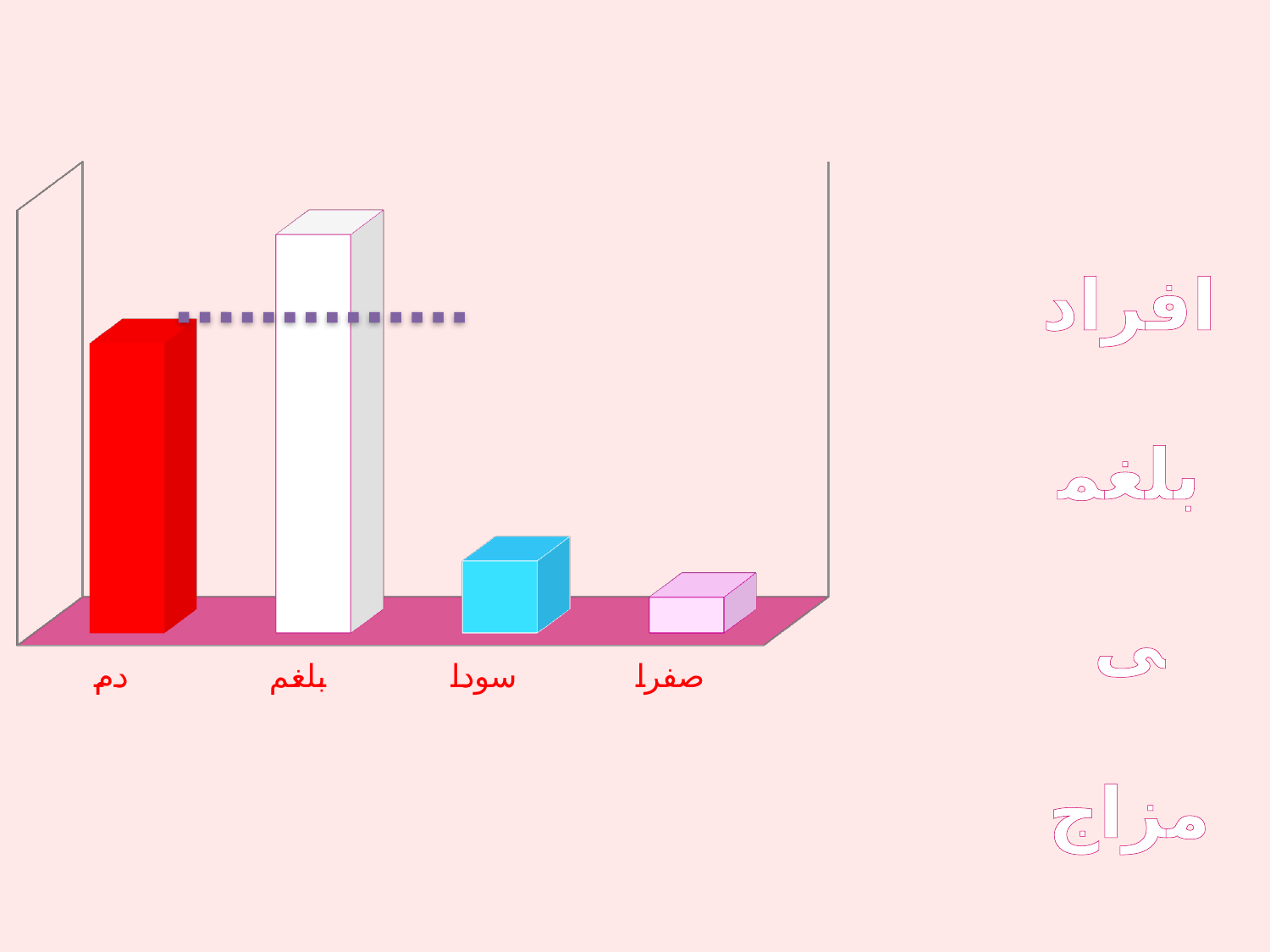
Which is larger, the bar for بلغم or the bar for دم? بلغم Which is larger, the bar for دم or the bar for سودا? دم Which is larger, the bar for سودا or the bar for صفرا? سودا Which category has the second-highest bar? دم What colour is the bar for دم? Red Which category has the highest bar? بلغم What colour is the bar for سودا? Blue Which category has the lowest bar? صفرا What kind of chart is shown on the slide? Bar chart How many categories are plotted on the chart? 4